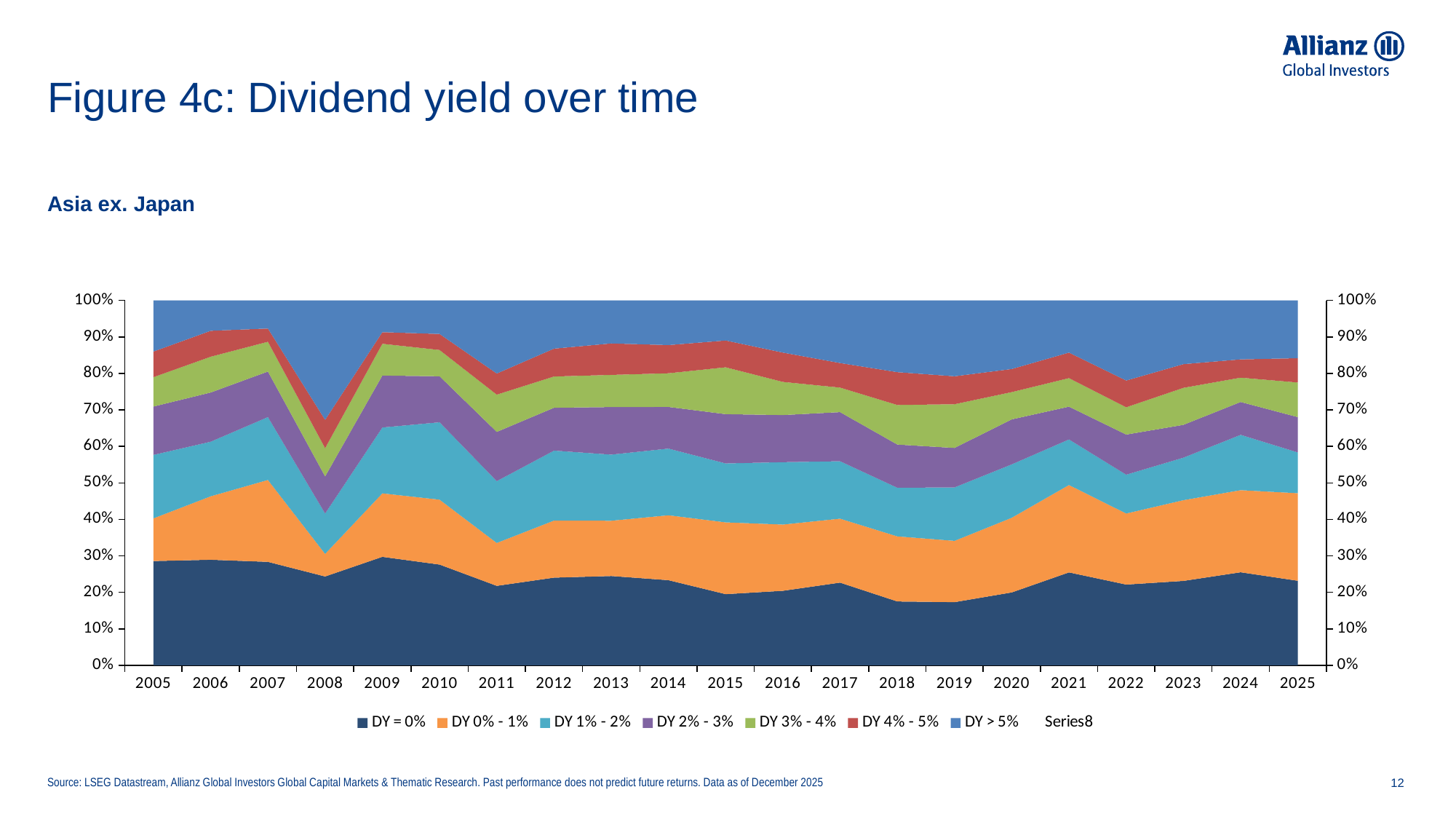
Does the DY = 0% share rise or fall from 2018 to 2021? Rise Is the value for DY = 0% in 2018 greater or less than 20%? less Which region does the chart cover, according to the subtitle? Asia ex. Japan Does the DY = 0% share rise or fall from 2005 to 2008? Fall Which is larger, the DY = 0% share in 2009 or in 2018? 2009 What is the first year shown on the x axis? 2005 How many series does the legend list? 8 Is the value for DY = 0% in 2021 greater or less than 20%? greater What kind of chart is shown on the slide? Stacked area chart How many years are plotted along the x axis? 21 What is the title of the figure? Figure 4c: Dividend yield over time Is the value for DY = 0% in 2008 greater or less than 30%? less